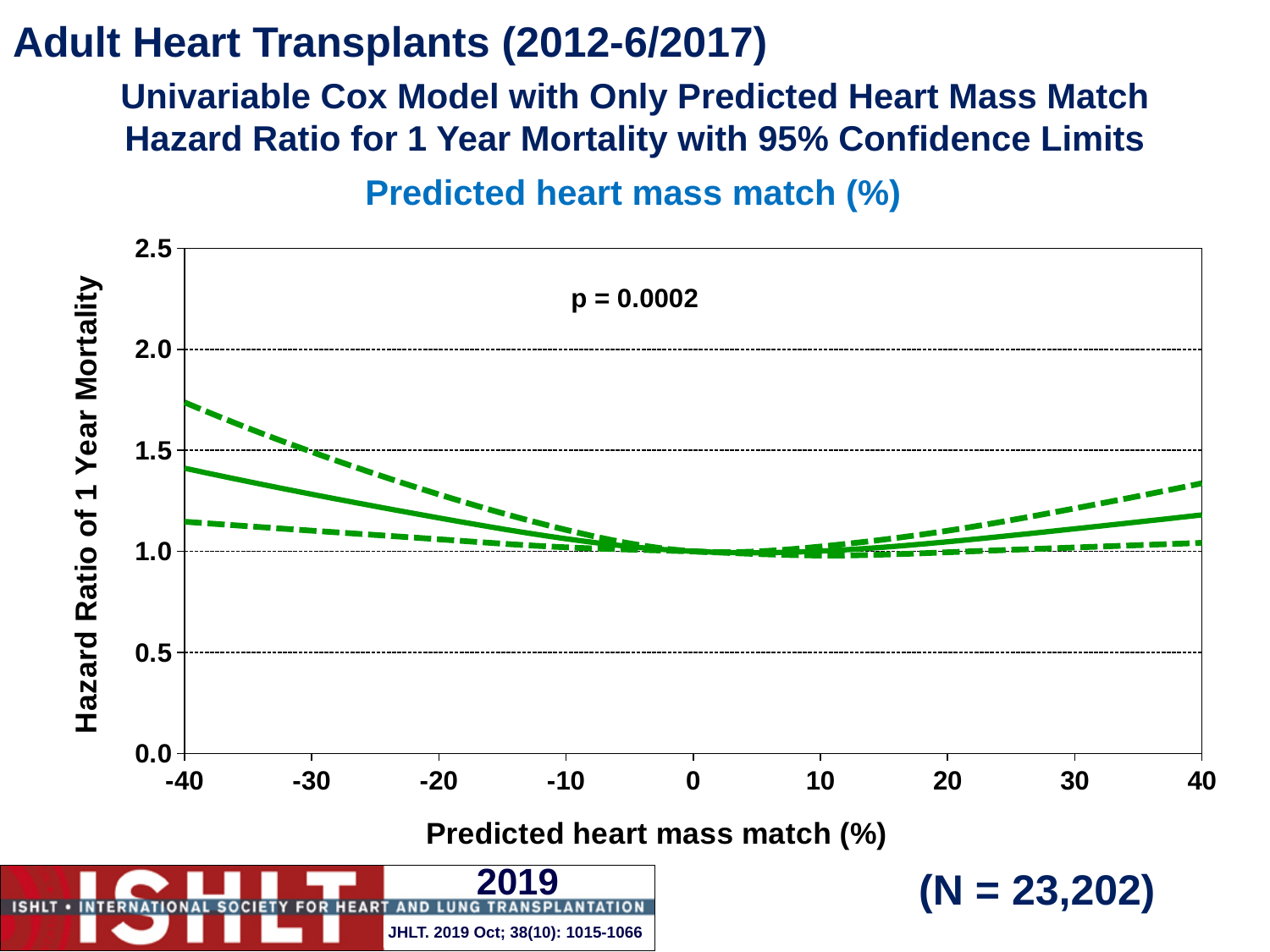
Does the solid hazard ratio line rise or fall as predicted heart mass match goes from -40% to 0%? fall How many lines are plotted on the chart? 3 What p-value is printed on the chart? p = 0.0002 Does the solid hazard ratio line rise or fall as predicted heart mass match goes from 10% to 40%? rise Is the hazard ratio on the solid line at a predicted heart mass match of 40% greater or less than 1.0? greater Is the upper dashed confidence limit at a predicted heart mass match of 40% greater or less than 1.5? less Is the hazard ratio on the solid line at a predicted heart mass match of -40% greater or less than 1.0? greater Is the hazard ratio on the solid line higher at a predicted heart mass match of -40% or at 40%? -40% What kind of chart is shown on the slide? line chart What sample size (N) is shown on the slide? N = 23,202